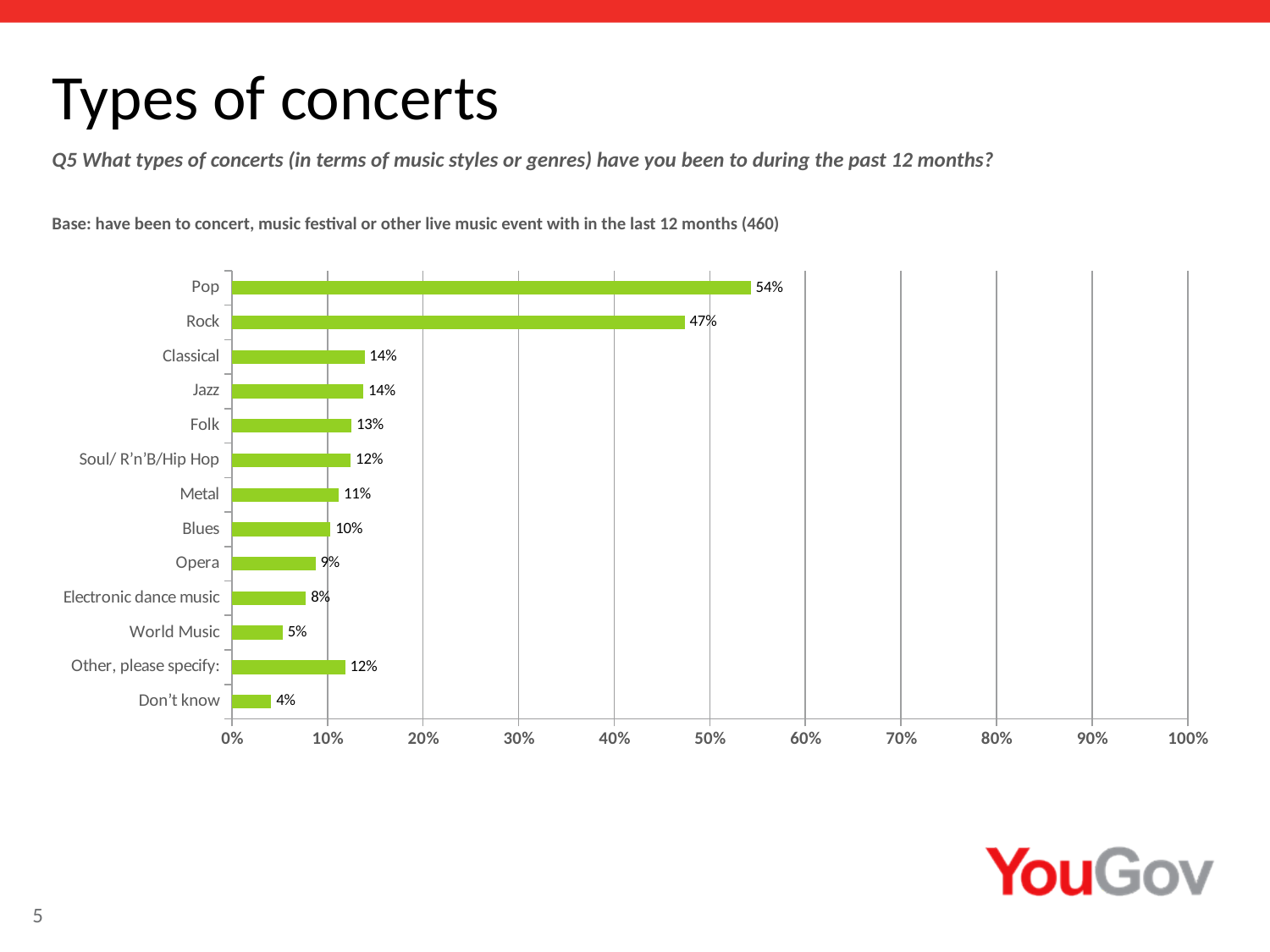
How many categories are shown on the chart? 13 What is the difference in percentage points between Folk and World Music? 8 Is the value for Rock greater or less than 40%? greater What percentage of respondents have been to a Pop concert? 54% What kind of chart is shown on the slide? Bar chart Which is larger, the value for Metal or the value for Blues? Metal Which category has the lowest percentage on the chart? Don't know What is the value shown for Rock? 47% What percentage is shown for Electronic dance music? 8% What is the difference in percentage points between Pop and Rock? 7 What is the base size stated for the chart? 460 Which type of concert has the highest percentage? Pop